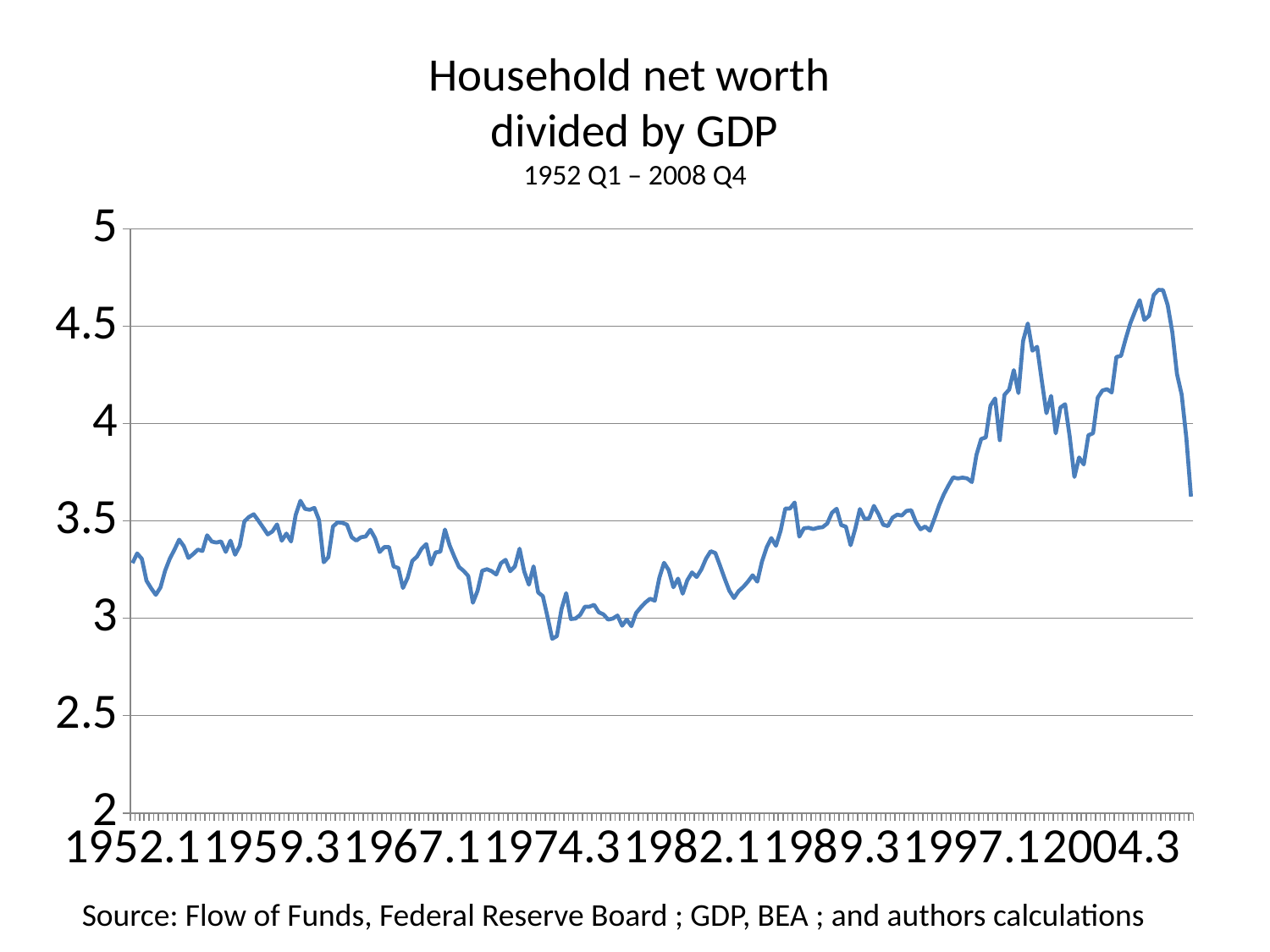
Is the value at 1989.3 greater or less than 4? less Is the final value at the end of the series (2008 Q4) greater or less than 4? less What kind of chart is shown on the slide? line chart Overall, does the line rise or fall from 1952 to 2008? rise Is the highest value reached by the line greater or less than 4.5? greater What period does the chart cover, according to its subtitle? 1952 Q1 – 2008 Q4 What is the title of the chart? Household net worth divided by GDP